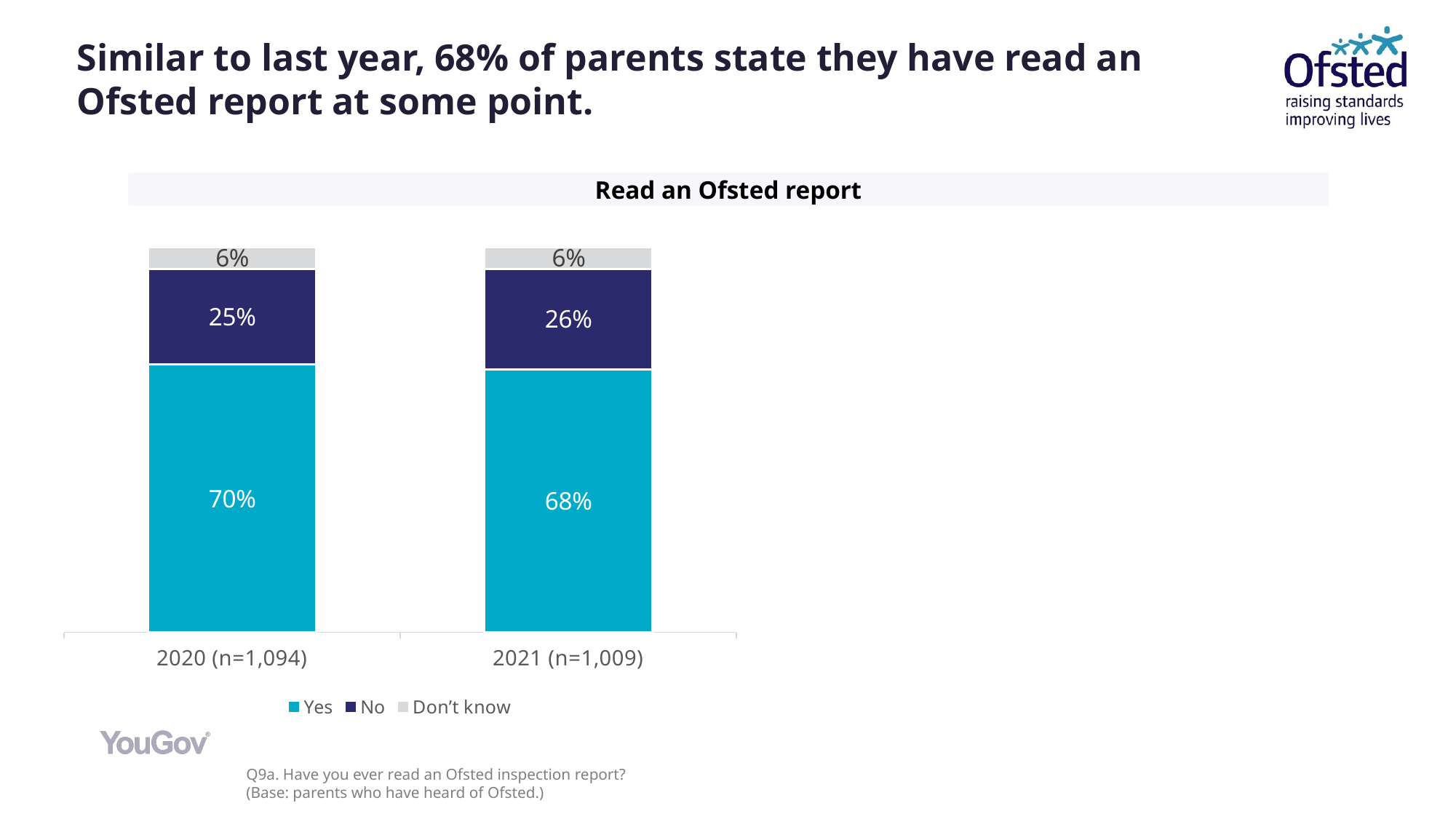
Is the No percentage larger in 2020 or 2021? 2021 What percentage of parents answered Yes in 2020 (n=1,094)? 70% What is the difference in the Yes percentage between 2020 and 2021? 2% What percentage of parents answered Don't know in 2021 (n=1,009)? 6% What percentage of parents answered Yes in 2021 (n=1,009)? 68% What percentage of parents answered No in 2020 (n=1,094)? 25% What is the title of the chart? Read an Ofsted report Which year has the higher Yes percentage? 2020 (n=1,094) What kind of chart is shown? Stacked bar chart Which year has the lower No percentage? 2020 (n=1,094) How many series does the legend list? 3 How many years (categories) are shown on the x axis? 2